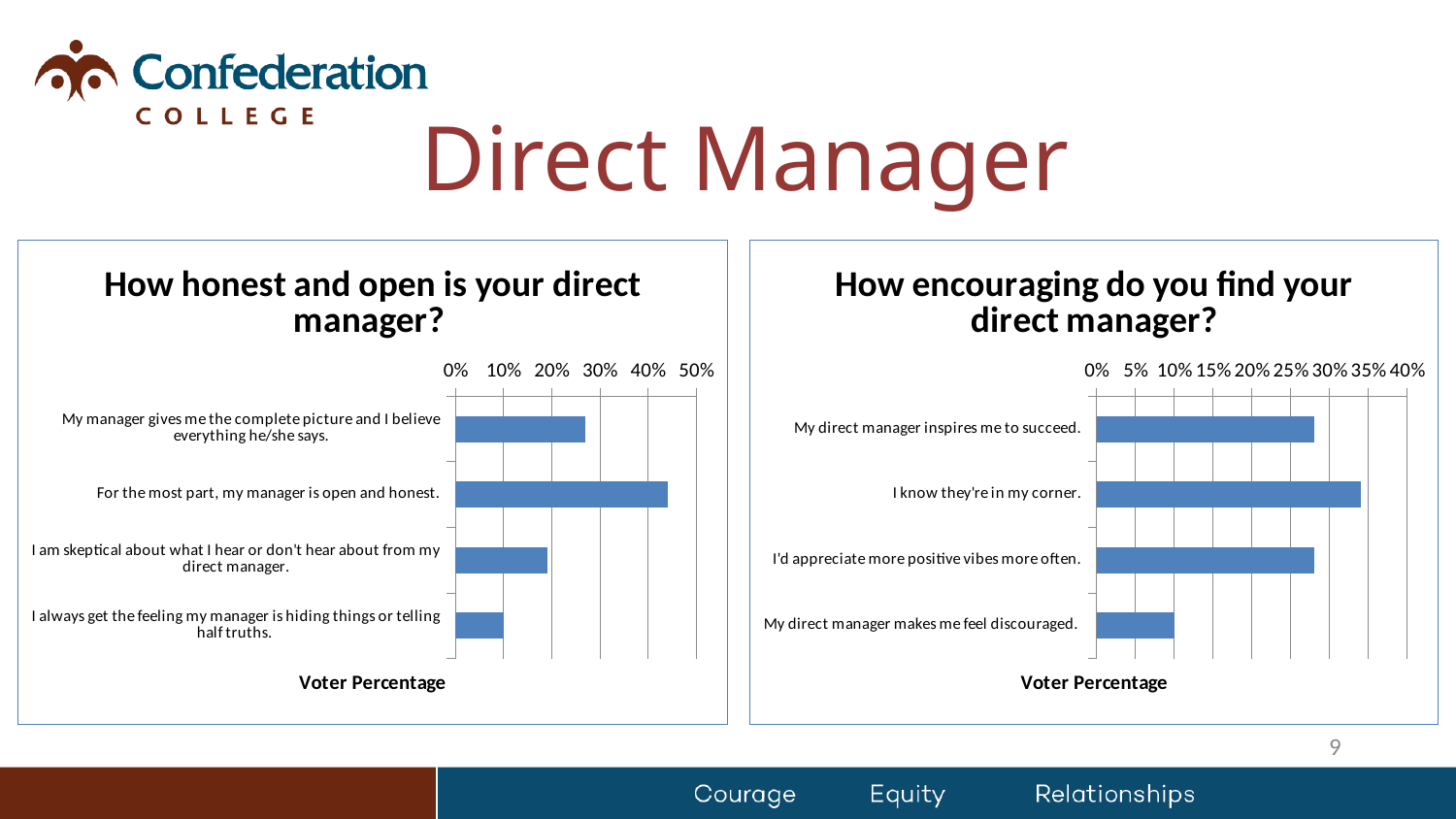
In the 'How encouraging do you find your direct manager?' chart, which category has the lowest value? My direct manager makes me feel discouraged. In the 'How honest and open is your direct manager?' chart, is the value for 'For the most part, my manager is open and honest.' greater or less than 40%? greater In the 'How encouraging do you find your direct manager?' chart, which category has the highest value? I know they're in my corner. In the 'How encouraging do you find your direct manager?' chart, is the value for 'My direct manager makes me feel discouraged.' greater or less than 15%? less In the 'How encouraging do you find your direct manager?' chart, is the value for 'I know they're in my corner.' greater or less than 30%? greater In the 'How honest and open is your direct manager?' chart, which category has the lowest value? I always get the feeling my manager is hiding things or telling half truths. In the 'How honest and open is your direct manager?' chart, which category has the highest value? For the most part, my manager is open and honest. What is the axis title shown below the bars in the 'How encouraging do you find your direct manager?' chart? Voter Percentage In the 'How honest and open is your direct manager?' chart, which is larger: 'My manager gives me the complete picture and I believe everything he/she says.' or 'I am skeptical about what I hear or don't hear about from my direct manager.'? My manager gives me the complete picture and I believe everything he/she says. What kind of chart is the 'How honest and open is your direct manager?' chart? bar chart How many categories are shown in the 'How honest and open is your direct manager?' chart? 4